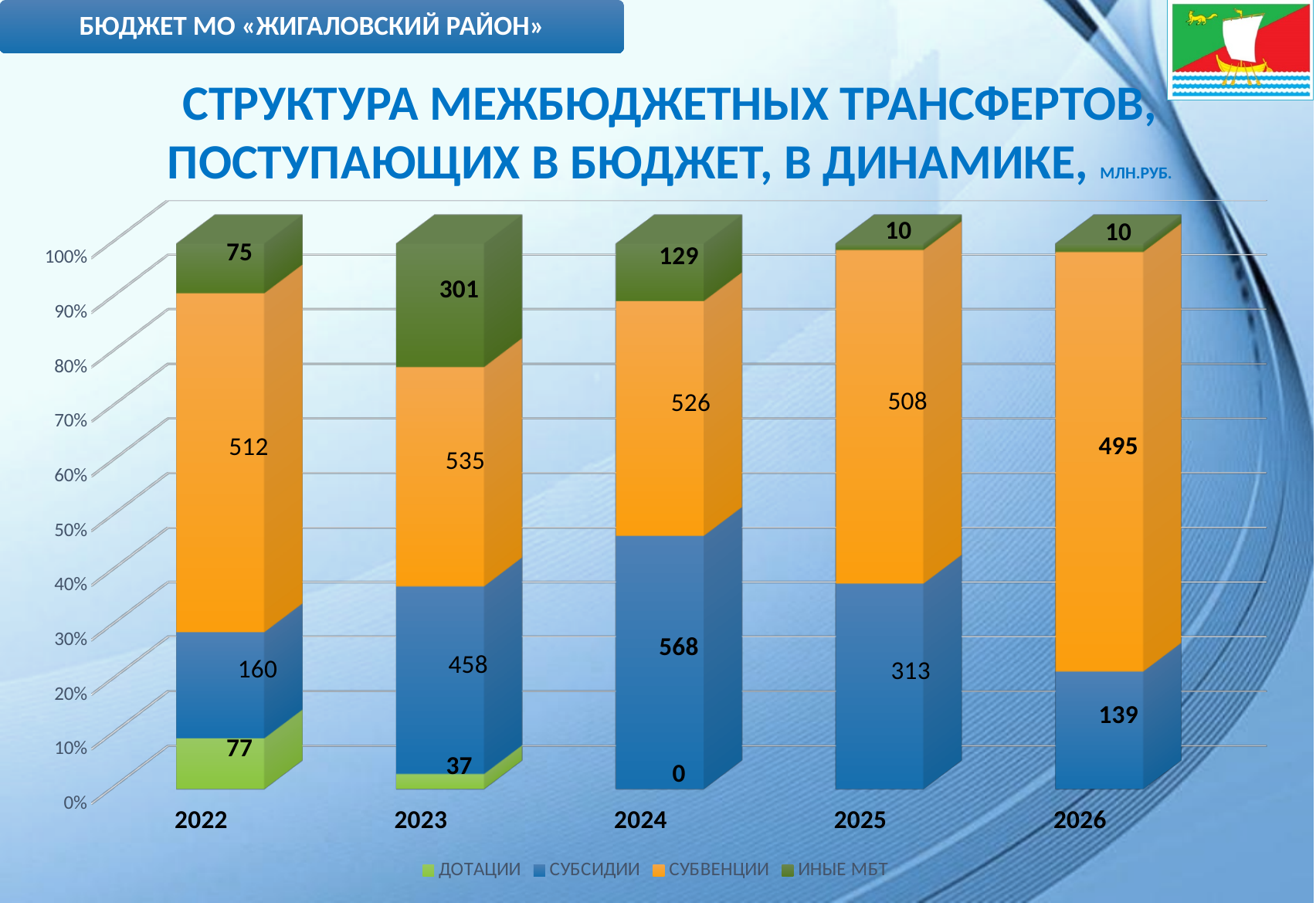
What is the total of the stacked bar for 2022? 824 In which year is the value for ИНЫЕ МБТ the lowest? 2025 and 2026 How many series does the legend list? 4 How many years are shown on the x axis? 5 What kind of chart is shown on the slide? Stacked bar chart What is the value for СУБСИДИИ in 2024? 568 In which year is the value for СУБСИДИИ the highest? 2024 What is the difference between the СУБВЕНЦИИ values for 2023 and 2026? 40 Which is larger, the СУБСИДИИ value for 2025 or for 2026? 2025 What is the value for ИНЫЕ МБТ in 2023? 301 What is the value for ДОТАЦИИ in 2022? 77 What is the value for СУБВЕНЦИИ in 2023? 535